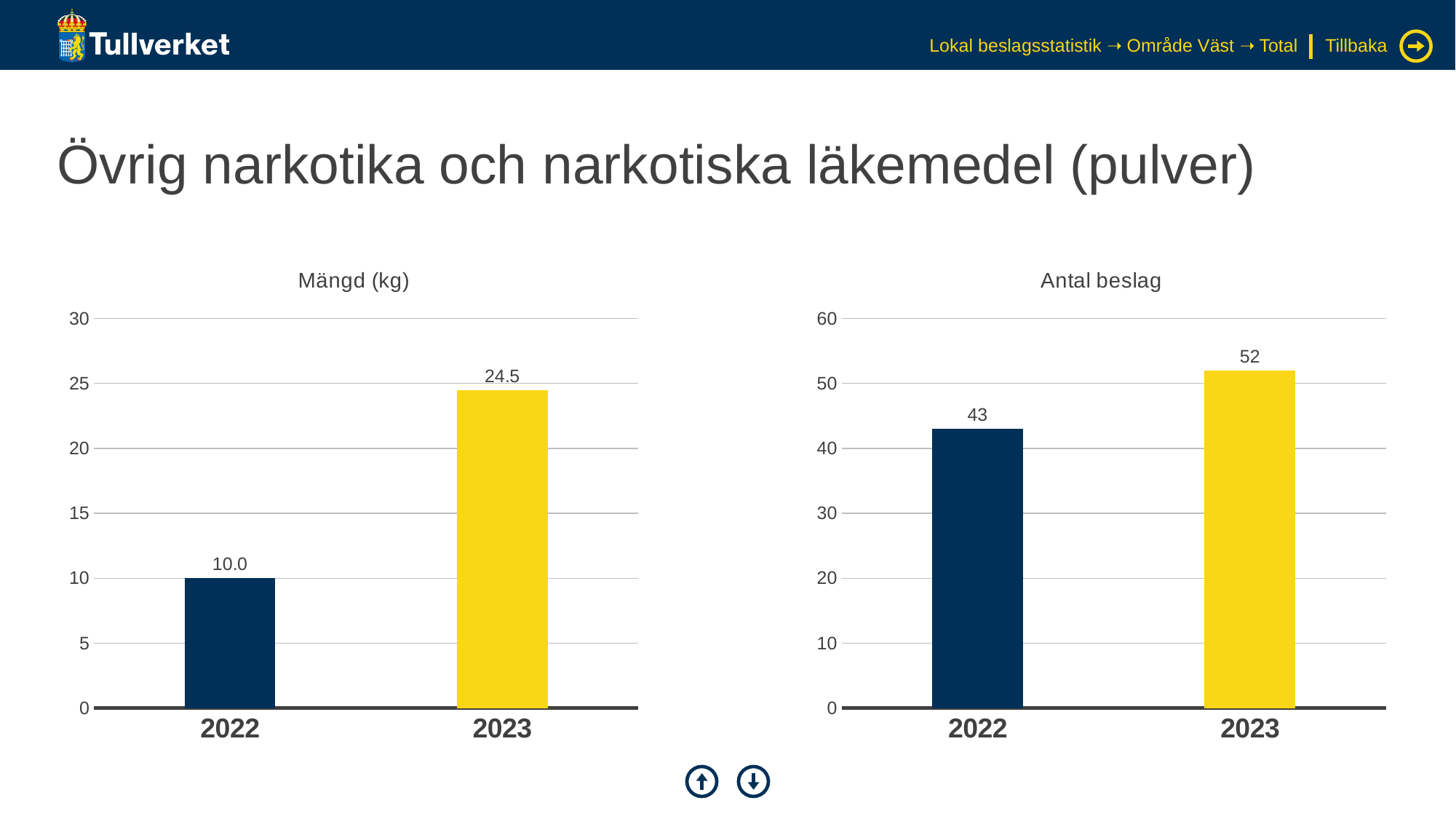
In the 'Antal beslag' chart, which year has the lowest value? 2022 In the 'Mängd (kg)' chart, what is the value for 2023? 24.5 In the 'Antal beslag' chart, what is the difference between the 2023 and 2022 values? 9 In the 'Antal beslag' chart, what is the value for 2022? 43 In the 'Mängd (kg)' chart, what is the value for 2022? 10.0 What kind of chart is the 'Antal beslag' chart? bar chart In the 'Mängd (kg)' chart, which year has the highest value? 2023 In the 'Antal beslag' chart, is the value for 2023 greater or less than 50? greater In the 'Mängd (kg)' chart, what is the difference between the 2023 and 2022 values? 14.5 In the 'Antal beslag' chart, what is the value for 2023? 52 How many categories are shown on the x axis of the 'Mängd (kg)' chart? 2 In the 'Mängd (kg)' chart, do the values rise or fall from 2022 to 2023? rise